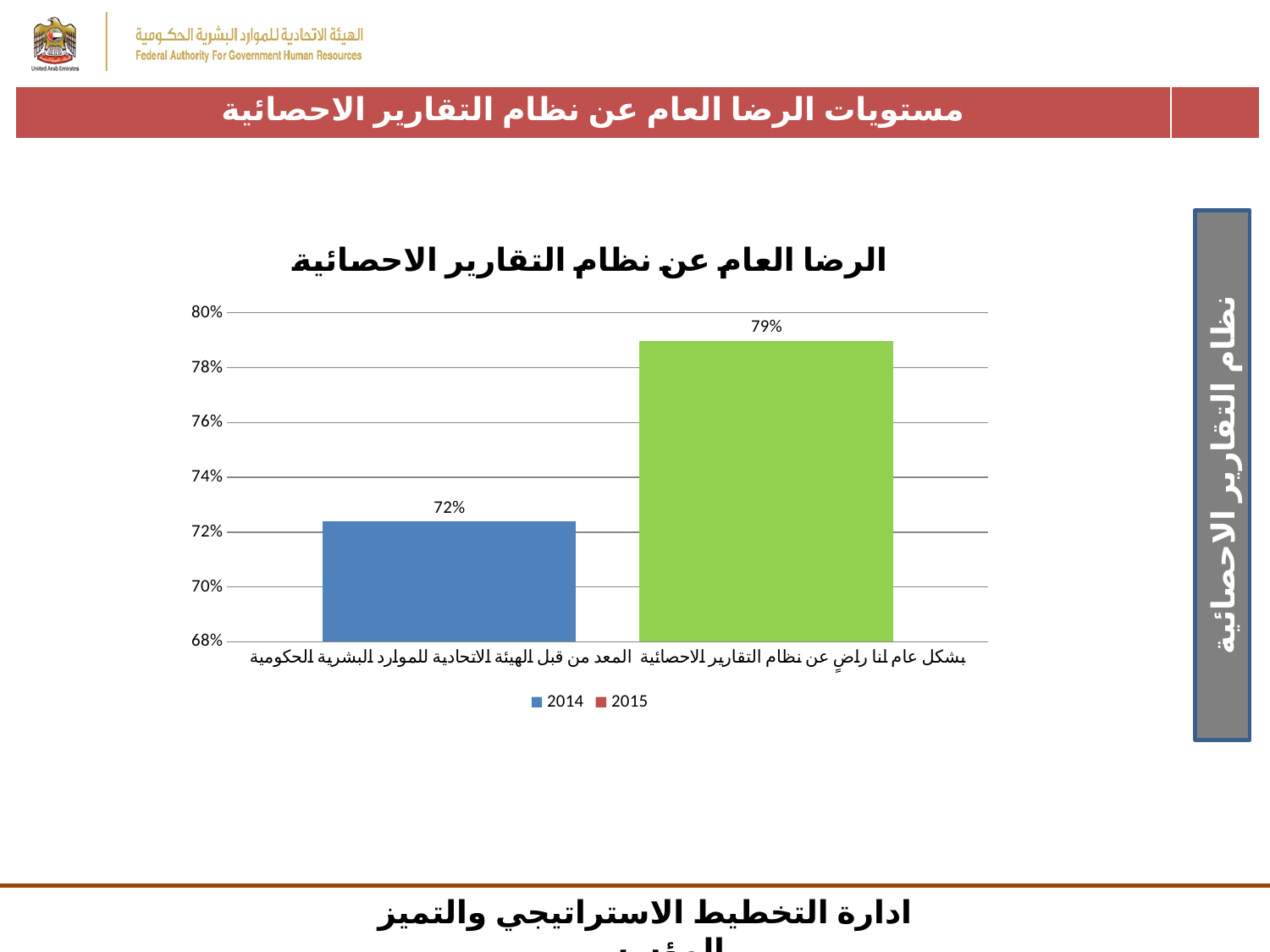
How many series does the legend list? 2 What is the title of the chart? الرضا العام عن نظام التقارير الاحصائية Is the value for 2015 larger than the value for 2014? Yes Is the value for 2015 greater or less than 78%? greater Which year has the higher value? 2015 What is the value for 2014? 72% Does the value rise or fall from 2014 to 2015? Rise What is the difference between the 2015 value and the 2014 value? 7% What is the value for 2015? 79% Is the value for 2014 greater or less than 74%? less What kind of chart is shown on the slide? Bar chart Which year has the lower value? 2014